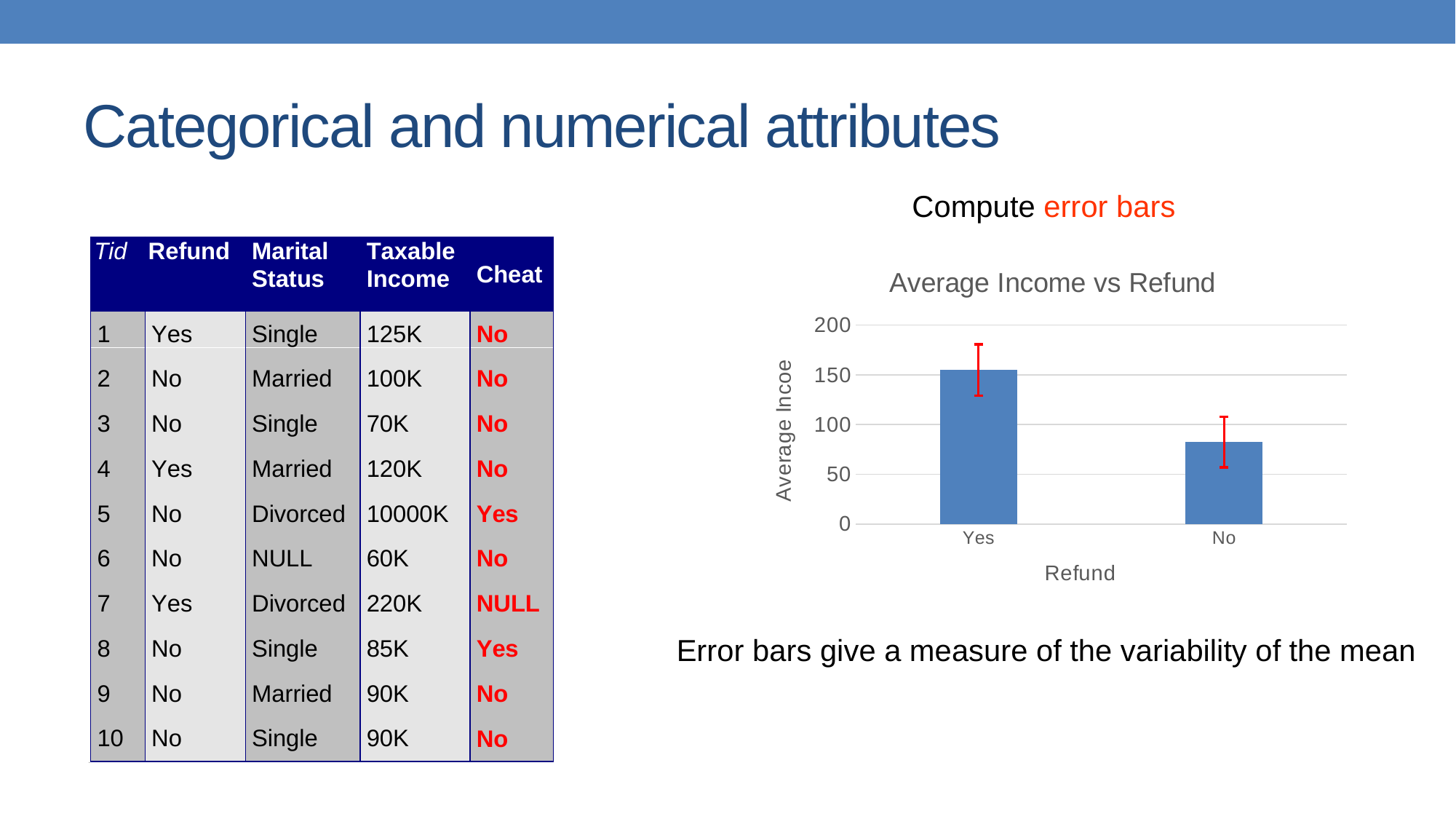
How many categories are plotted on the x axis of the chart? 2 Is the value for Yes greater or less than 100? greater What is the label of the x axis of the chart? Refund Is the value for No greater or less than 100? less What is the title of the chart? Average Income vs Refund Is the value for Yes greater or less than 200? less What kind of chart is shown on the slide? bar chart Which category has the highest bar in the chart? Yes Which category has the lowest bar in the chart? No Which bar is taller, Yes or No? Yes